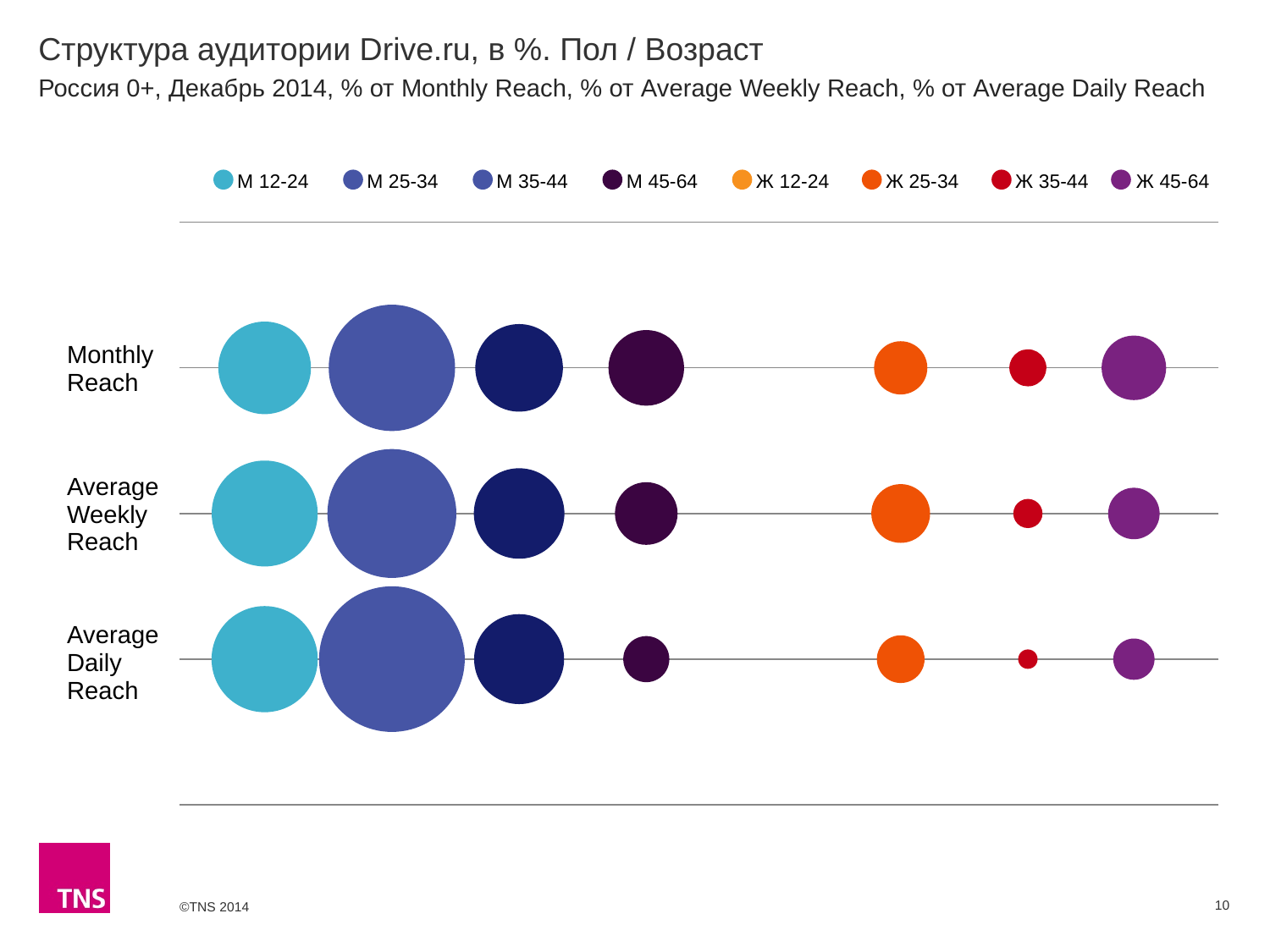
In the Monthly Reach row, which bubble is larger: М 45-64 or Ж 35-44? М 45-64 Which series has the largest bubble in the Monthly Reach row? М 25-34 How many series does the legend list? 8 What is the title of the chart on the slide? Структура аудитории Drive.ru, в %. Пол / Возраст Does the М 45-64 bubble get larger or smaller going from Monthly Reach to Average Daily Reach? smaller Which series has the largest bubble in the Average Daily Reach row? М 25-34 In the Monthly Reach row, which bubble is larger: М 12-24 or Ж 45-64? М 12-24 Which series has the smallest visible bubble in the Average Daily Reach row? Ж 35-44 How many reach categories (rows) are plotted on the chart? 3 In the Average Weekly Reach row, which bubble is larger: М 35-44 or Ж 25-34? М 35-44 What kind of chart is shown on the slide? bubble chart What colour represents the Ж 25-34 series in the legend? orange